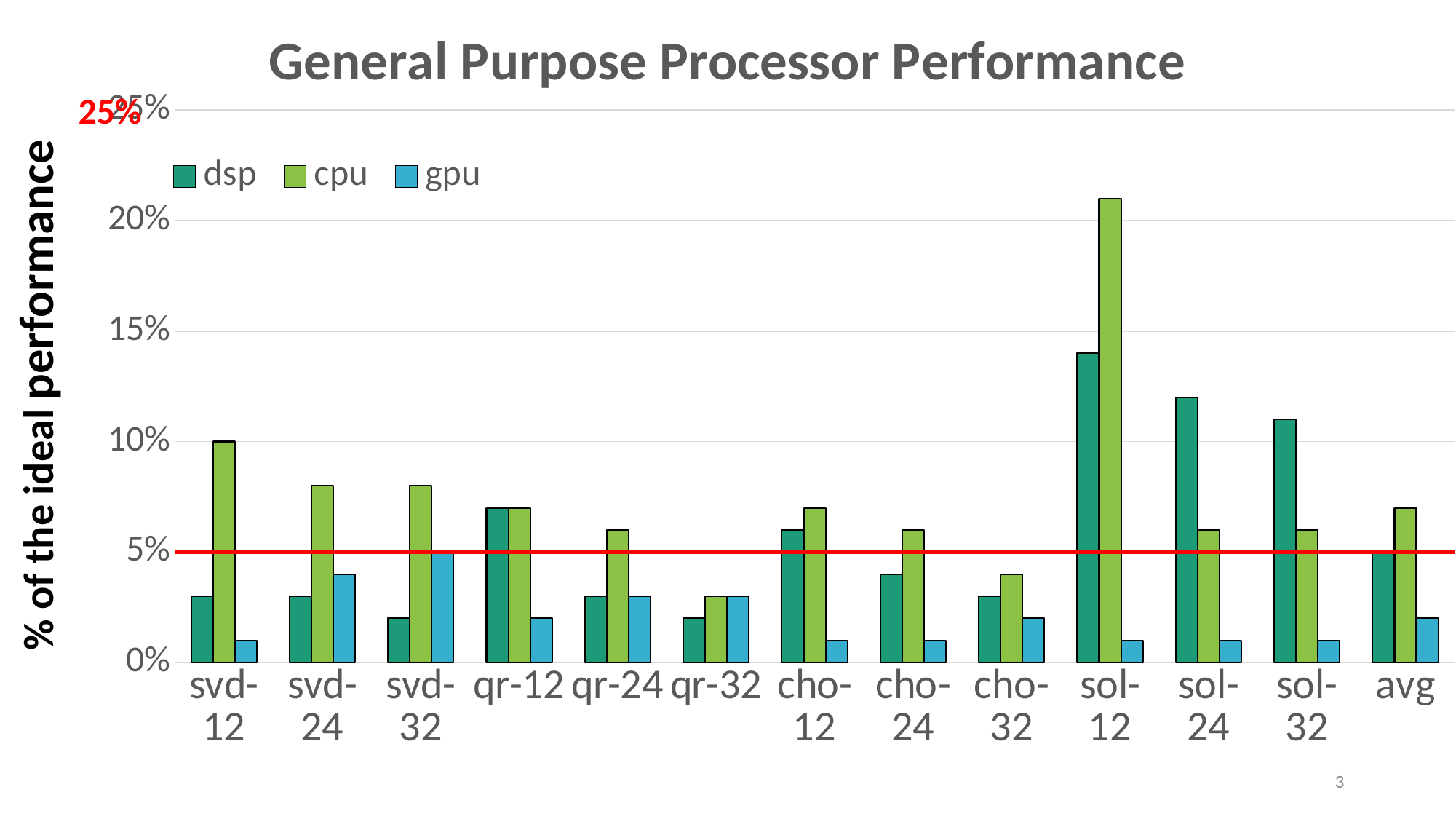
For svd-12, which is larger, the dsp value or the cpu value? cpu Is the cpu value for sol-12 greater or less than 20%? greater Which category has the highest dsp value? sol-12 Which category has the highest cpu value? sol-12 Is the dsp value for sol-12 greater or less than 10%? greater What is the y-axis title of the chart? % of the ideal performance How many categories are shown on the x axis? 13 What is the title of the chart? General Purpose Processor Performance How many series does the legend list? 3 What kind of chart is shown on the slide? bar chart Is the gpu value for svd-12 greater or less than 5%? less For sol-24, which is larger, the dsp value or the cpu value? dsp